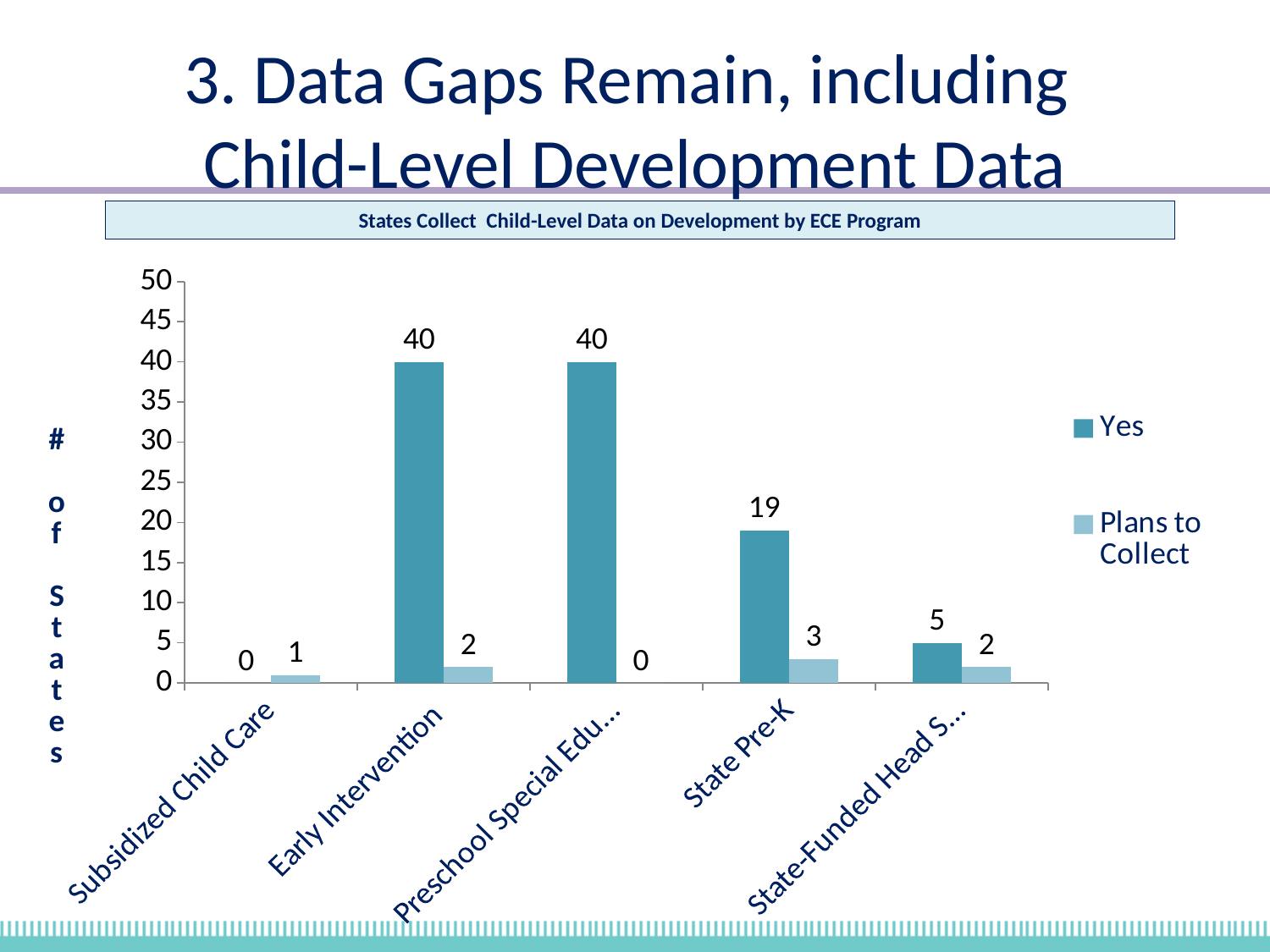
What is the 'Yes' value for Early Intervention? 40 How many series does the legend list? 2 What is the 'Plans to Collect' value for State Pre-K? 3 Which program has the highest 'Plans to Collect' value? State Pre-K Which program has the lowest 'Yes' value? Subsidized Child Care What kind of chart is shown on the slide? Bar chart Which is larger: the 'Yes' value for State Pre-K or the 'Plans to Collect' value for State Pre-K? Yes What is the 'Plans to Collect' value for Subsidized Child Care? 1 What is the difference between the 'Yes' values for Early Intervention and State Pre-K? 21 What is the 'Yes' value for State Pre-K? 19 How many ECE program categories are shown on the x axis? 5 What is the 'Yes' value for Subsidized Child Care? 0